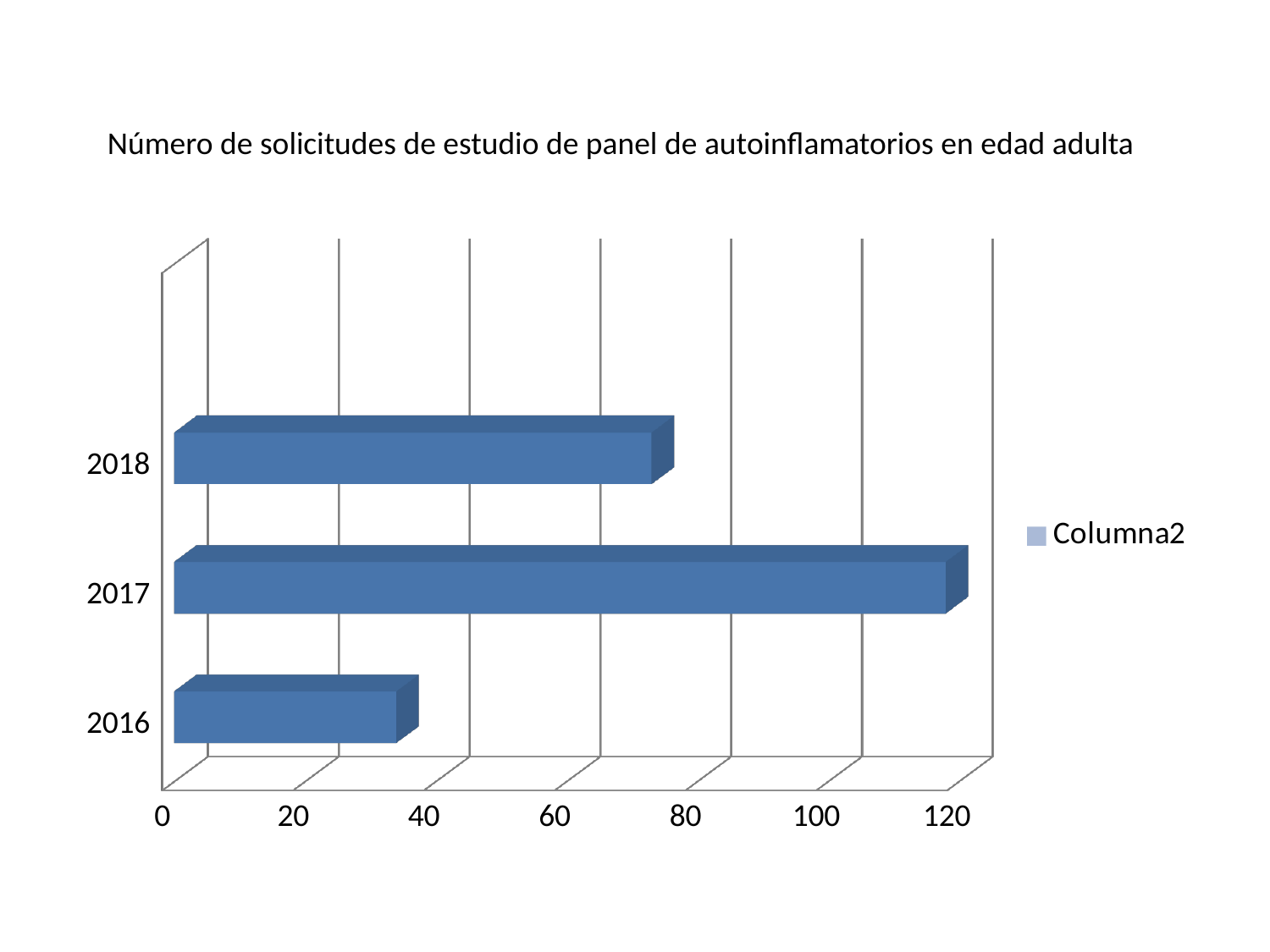
Which year has the lowest number of requests? 2016 Is the value for 2017 greater or less than 100? greater Is the value for 2018 greater or less than 60? greater What is the title of the chart? Número de solicitudes de estudio de panel de autoinflamatorios en edad adulta How many years (categories) are plotted in the chart? 3 What kind of chart is shown on the slide? bar chart Which year has the larger value, 2018 or 2016? 2018 Is the value for 2016 greater or less than 40? less Which year has the highest number of requests? 2017 How many series does the legend list? 1 Does the value rise or fall from 2017 to 2018? fall What is the name of the series shown in the legend? Columna2